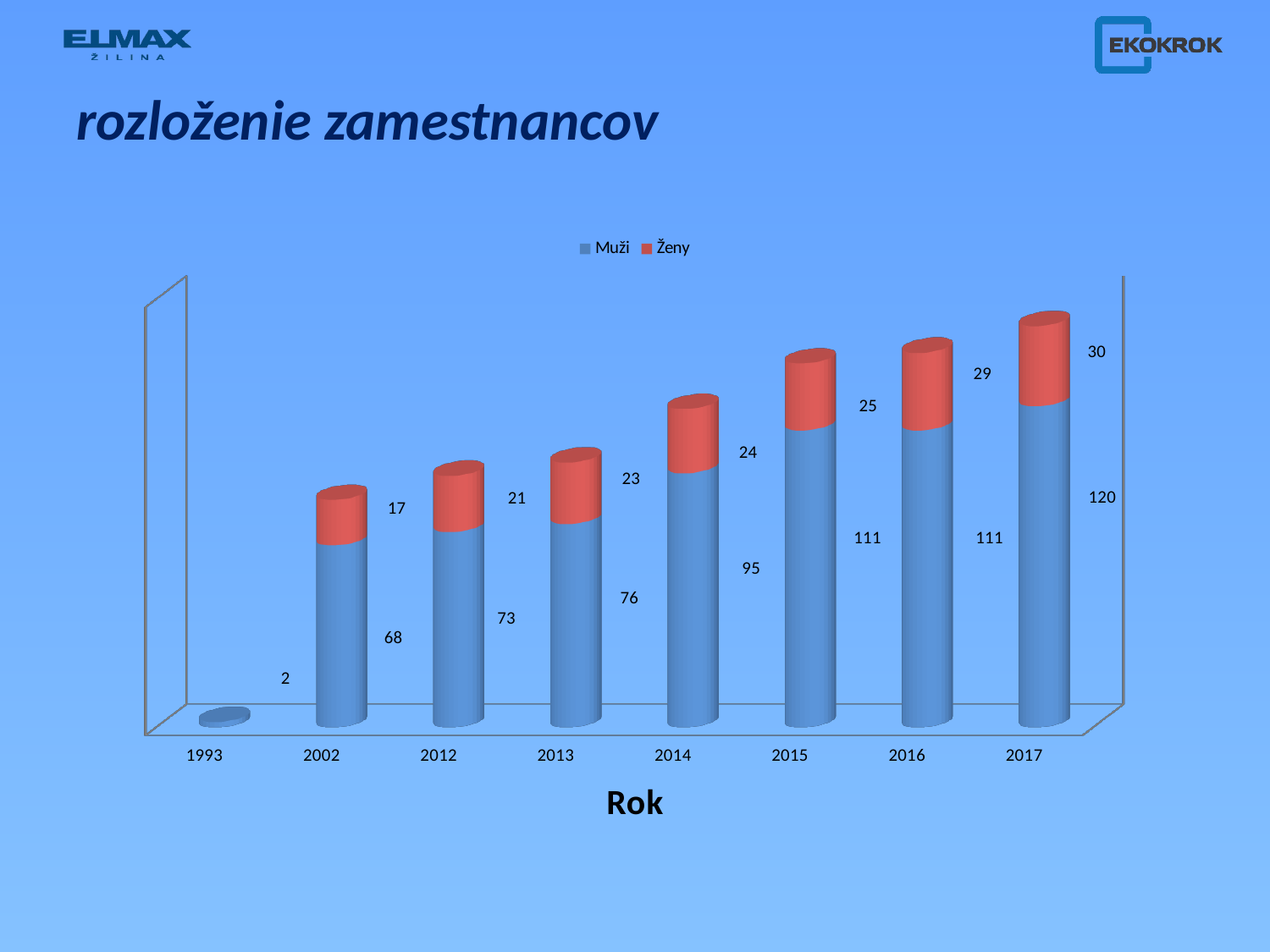
Which year has the highest Ženy value? 2017 How many series does the legend list? 2 Which year has the lowest Muži value? 1993 How many years are shown on the x axis? 8 What kind of chart is shown on the slide? Stacked bar chart Do the Muži values generally rise or fall from 1993 to 2017? Rise What is the difference between the Muži values for 2017 and 2015? 9 Which is larger, the Ženy value for 2012 or the Ženy value for 2013? 2013 What is the Muži value for 2017? 120 What is the Muži value for 1993? 2 What is the total of the stacked bar for 2016? 140 What is the Ženy value for 2014? 24